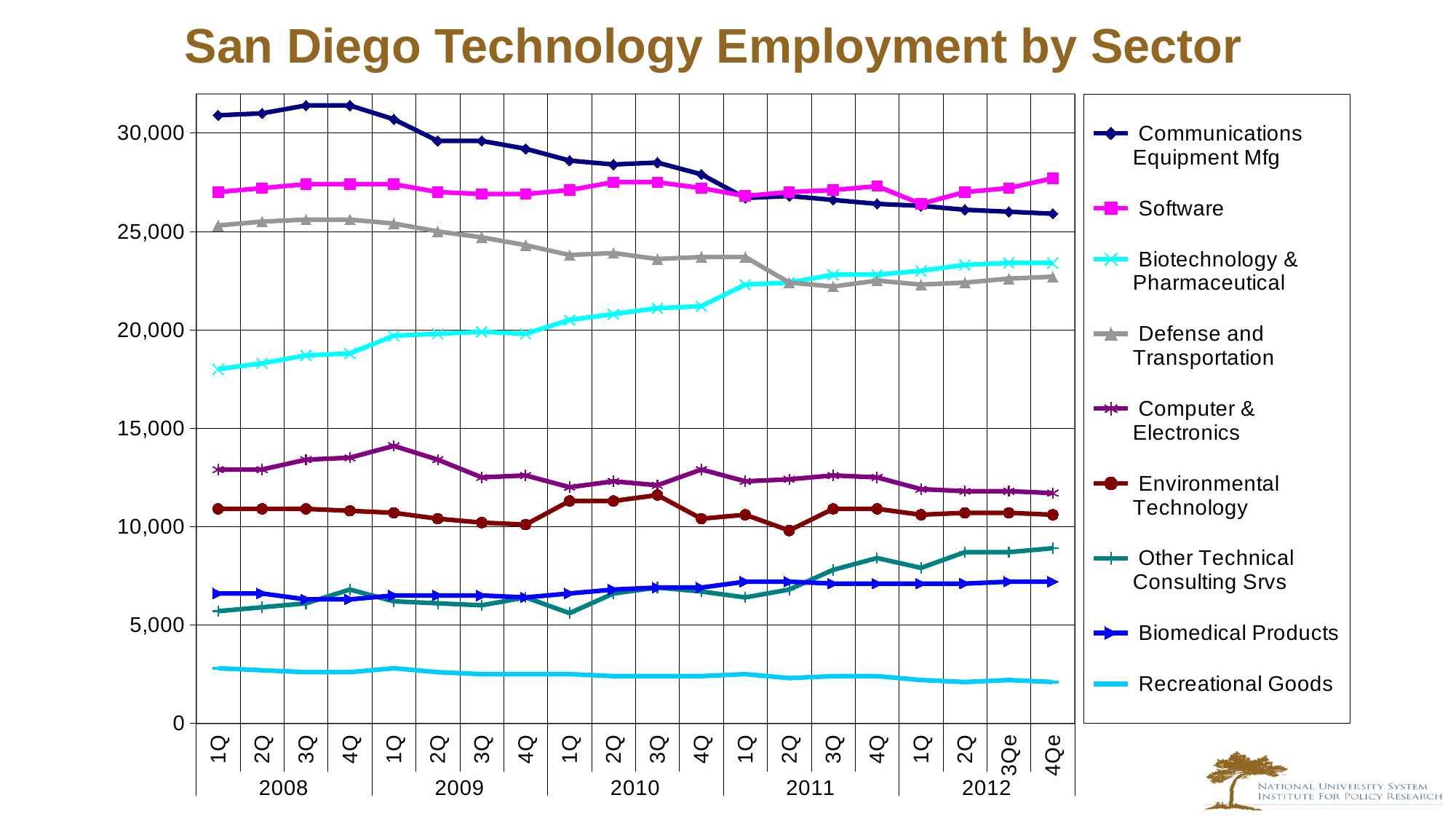
Which sector has the highest employment in 1Q 2008? Communications Equipment Mfg How many series does the legend list? 9 In 4Qe 2012, which is larger: Software or Communications Equipment Mfg? Software Which sector has the lowest employment across the whole period? Recreational Goods How many quarterly data points are plotted along the x axis for each series? 20 What is the title of the chart? San Diego Technology Employment by Sector Does employment in Communications Equipment Mfg rise or fall from 1Q 2008 to 4Qe 2012? fall What kind of chart is shown on the slide? line chart Does employment in Biotechnology & Pharmaceutical rise or fall from 1Q 2008 to 4Qe 2012? rise Is the value for Software in 1Q 2008 greater or less than 25,000? greater Which sector has the highest employment in 4Qe 2012? Software Is the value for Biotechnology & Pharmaceutical in 1Q 2008 greater or less than 20,000? less